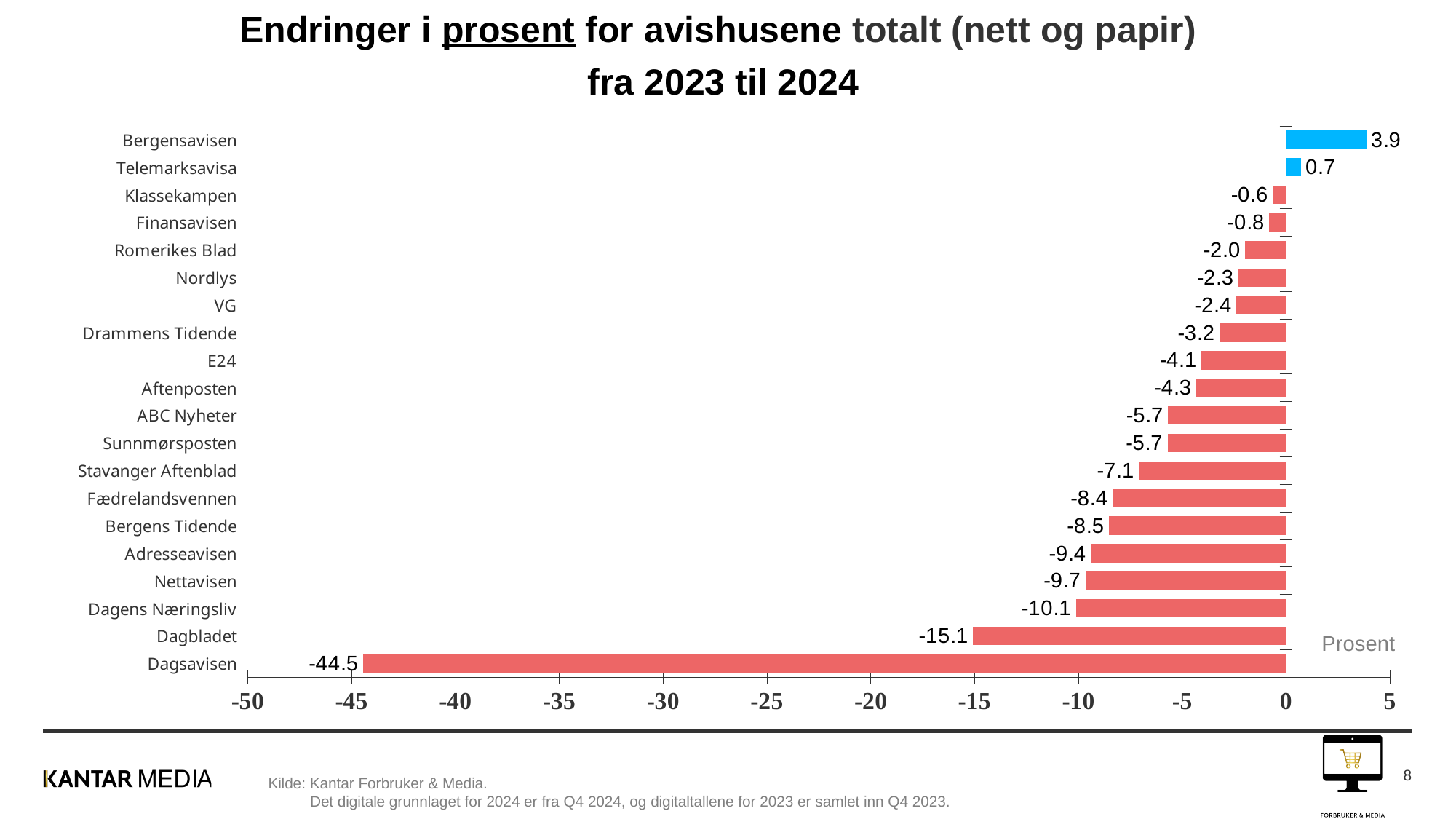
What kind of chart is shown on the slide? bar chart Which has a larger value, Aftenposten or Adresseavisen? Aftenposten Is the value for Dagens Næringsliv greater or less than -5? less Which newspaper has the highest value? Bergensavisen How many newspapers have a positive value (blue bars)? 2 What is the value for Bergensavisen? 3.9 How many newspapers are shown in the chart? 20 What is the value for VG? -2.4 What is the value for Dagbladet? -15.1 What is the difference between the values for Dagsavisen and Dagbladet? 29.4 Which newspaper has the lowest value? Dagsavisen What is the value for Nettavisen? -9.7